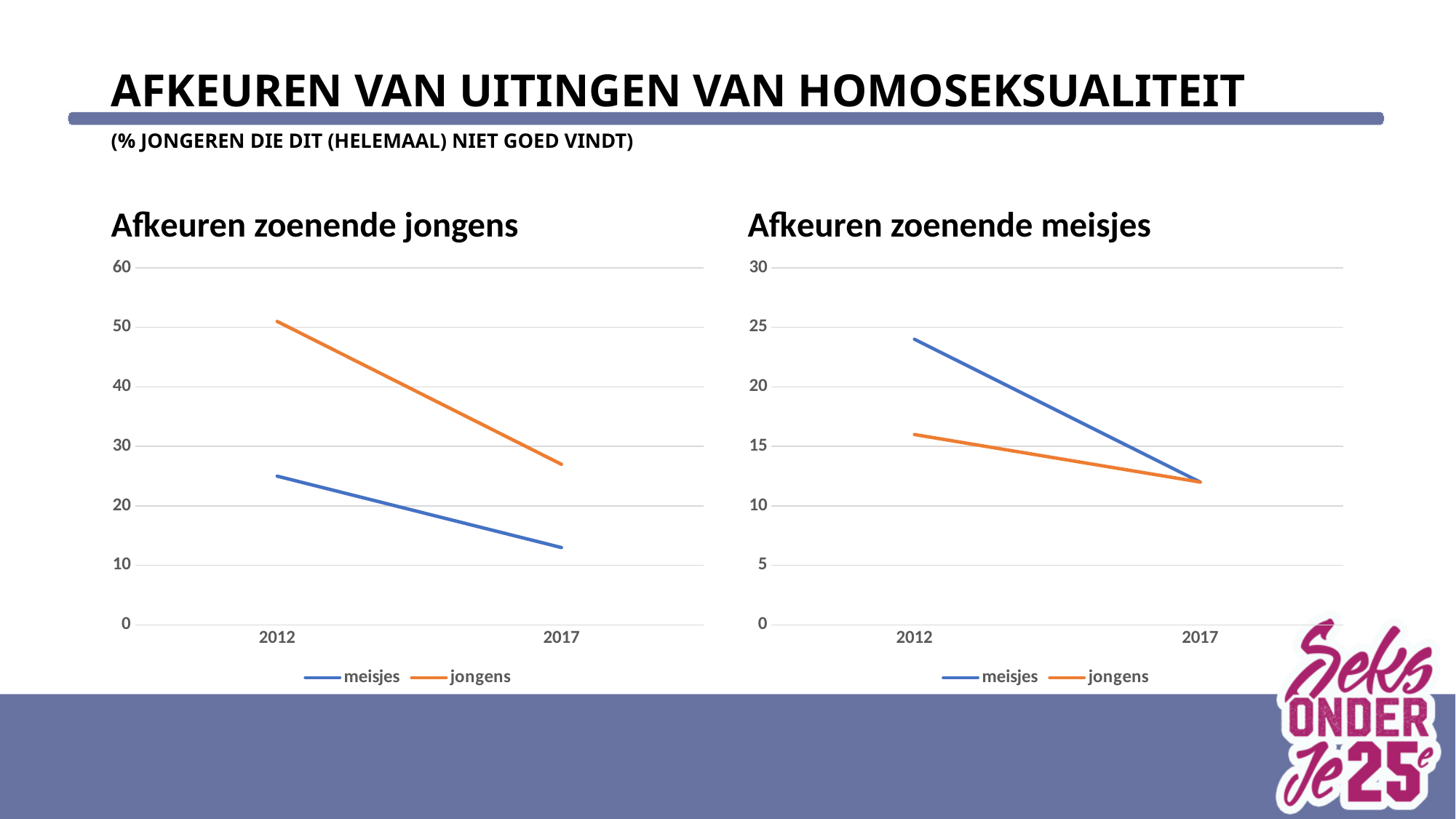
In the 'Afkeuren zoenende meisjes' chart, how many years are shown on the x axis? 2 What kind of chart is the 'Afkeuren zoenende jongens' chart? line chart In the 'Afkeuren zoenende meisjes' chart, is the value for meisjes in 2012 greater or less than 20? greater In the 'Afkeuren zoenende jongens' chart, is the value for jongens in 2012 greater or less than 40? greater In the 'Afkeuren zoenende jongens' chart, is the value for jongens in 2017 greater or less than 30? less In the 'Afkeuren zoenende jongens' chart, which series has the higher value in 2012, meisjes or jongens? jongens In the 'Afkeuren zoenende meisjes' chart, which series has the higher value in 2012, meisjes or jongens? meisjes In the 'Afkeuren zoenende jongens' chart, how many series does the legend list? 2 In the 'Afkeuren zoenende jongens' chart, does the jongens line rise or fall from 2012 to 2017? fall In the 'Afkeuren zoenende meisjes' chart, which colour is used for the jongens line? orange